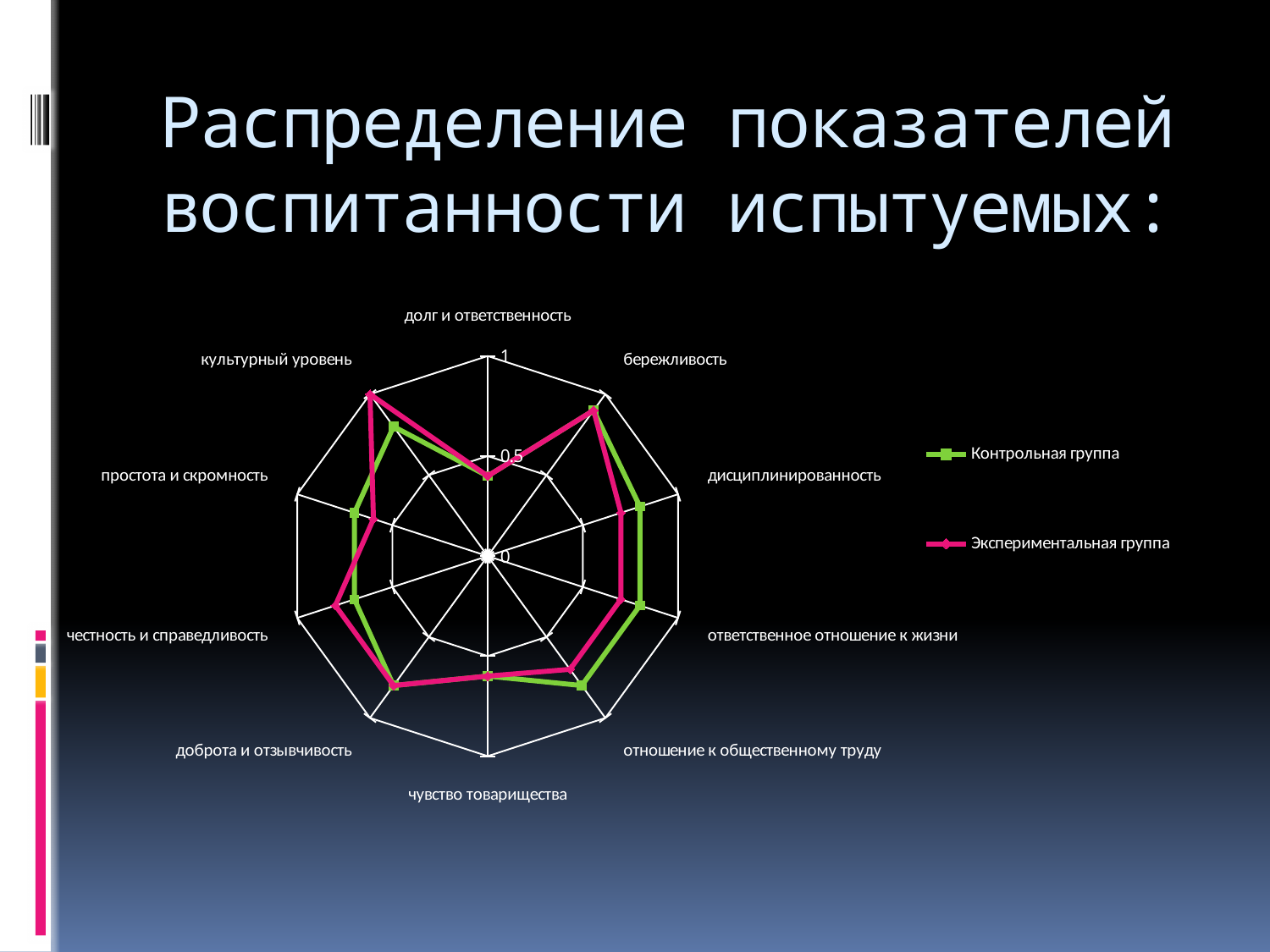
Which series is drawn in pink? Экспериментальная группа Is the value of Контрольная группа for долг и ответственность greater or less than 0.5? less For which category does Экспериментальная группа have its highest value? культурный уровень What kind of chart is shown on the slide? radar chart For отношение к общественному труду, which series has the larger value, Контрольная группа or Экспериментальная группа? Контрольная группа For культурный уровень, which series has the larger value, Контрольная группа or Экспериментальная группа? Экспериментальная группа Is the value of Контрольная группа for дисциплинированность greater or less than 0.5? greater Is the value of Экспериментальная группа for культурный уровень greater or less than 0.5? greater How many series does the legend list? 2 How many categories (axes) does the radar chart have? 10 Which series is drawn in green? Контрольная группа